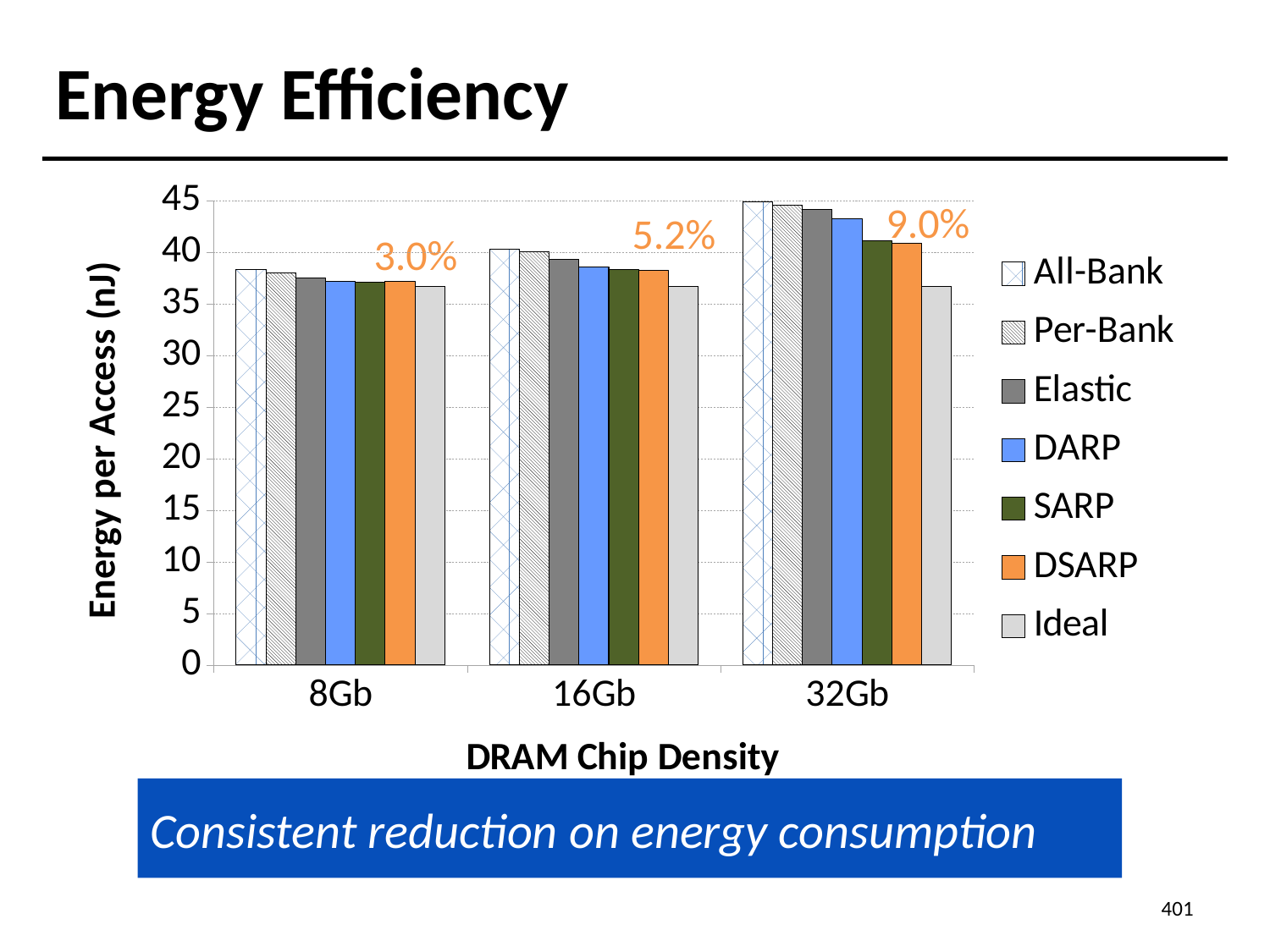
How many series does the legend list? 7 What percentage is annotated above the 32Gb group of bars? 9.0% Is the All-Bank value for 8Gb greater or less than 35? greater Is the All-Bank value for 32Gb greater or less than 40? greater How many DRAM chip density categories are shown on the x axis? 3 What kind of chart is shown on the slide? bar chart At 32Gb, which is larger: the All-Bank value or the Ideal value? All-Bank For which DRAM chip density is the All-Bank energy per access highest? 32Gb Do the All-Bank values rise or fall as DRAM chip density increases from 8Gb to 32Gb? rise Is the SARP value for 16Gb greater or less than 40? less Which is larger: the All-Bank value for 32Gb or the All-Bank value for 8Gb? 32Gb